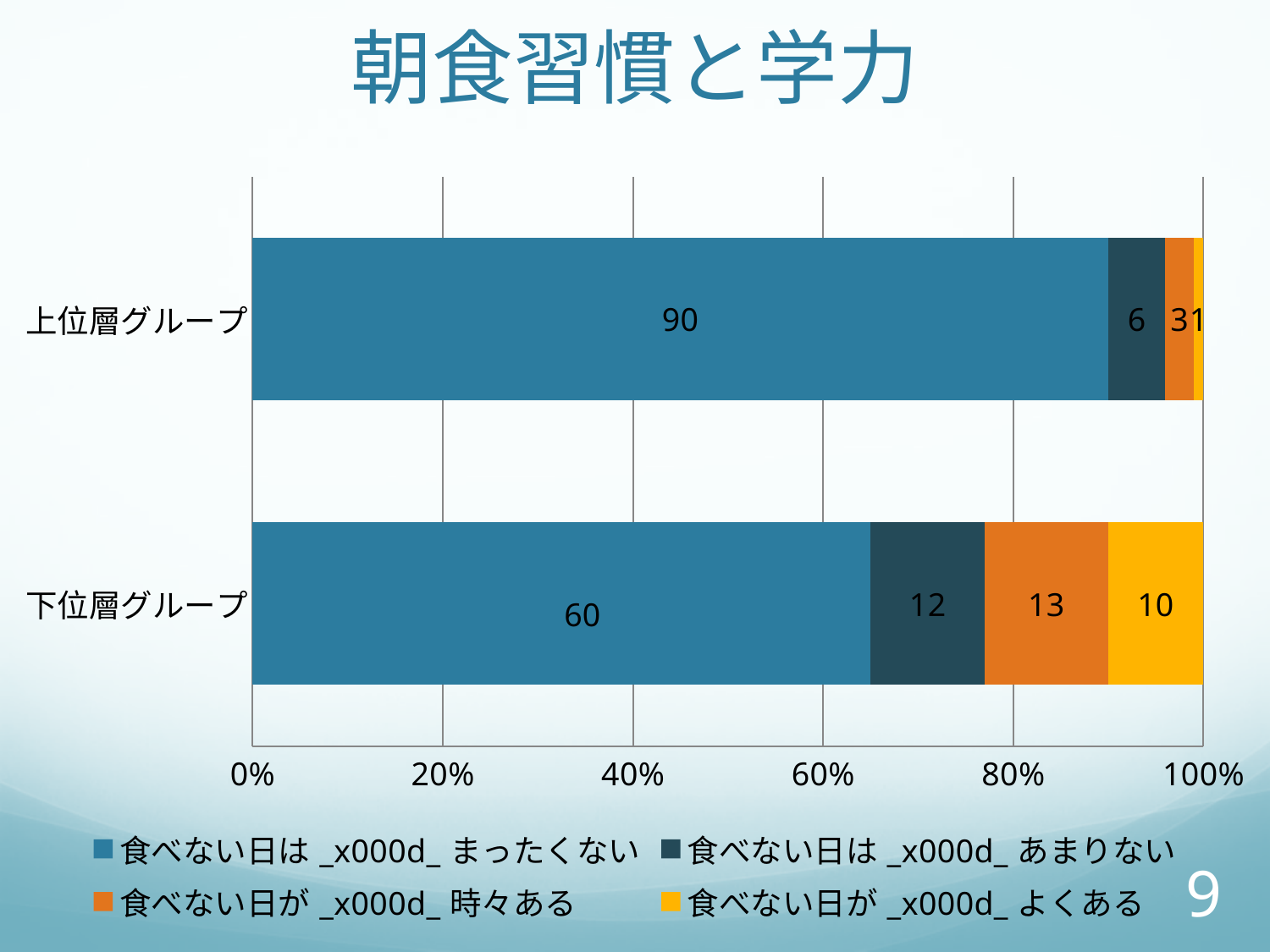
What is the value for 下位層グループ in the 食べない日が 時々ある series? 13 What is the difference between the 食べない日は まったくない values for 上位層グループ and 下位層グループ? 30 How many series does the legend list? 4 What is the value for 下位層グループ in the 食べない日は まったくない series? 60 How many groups (categories) are shown on the chart? 2 What kind of chart is shown on the slide? Stacked bar chart What is the value for 下位層グループ in the 食べない日が よくある series? 10 Which group has the larger value for 食べない日は まったくない, 上位層グループ or 下位層グループ? 上位層グループ What is the value for 下位層グループ in the 食べない日は あまりない series? 12 What is the value for 上位層グループ in the 食べない日は まったくない series? 90 What is the title of the slide? 朝食習慣と学力 What is the value for 上位層グループ in the 食べない日は あまりない series? 6